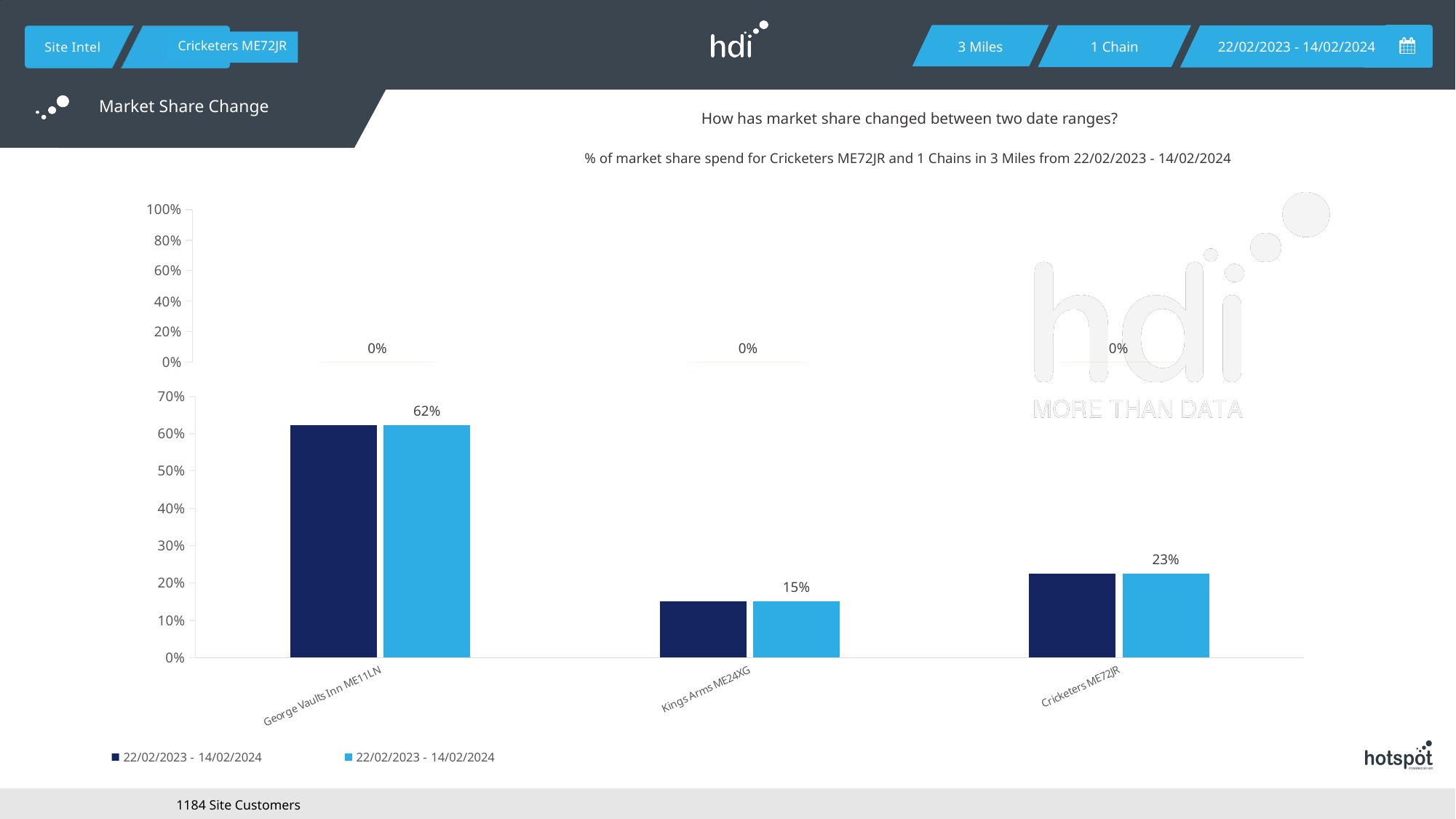
In the bottom chart, what value is labelled for Kings Arms ME24XG? 15% In the bottom chart, what is the difference between the labelled values for George Vaults Inn ME11LN and Cricketers ME72JR? 39% How many categories are shown on the x axis of the bottom chart? 3 In the bottom chart, what value is labelled for Cricketers ME72JR? 23% In the bottom chart, which has the larger market share, Cricketers ME72JR or Kings Arms ME24XG? Cricketers ME72JR What kind of chart is the bottom chart? bar chart In the top chart, what value is labelled for Kings Arms ME24XG? 0% In the bottom chart, is the value for George Vaults Inn ME11LN greater or less than 50%? greater In the bottom chart, what value is labelled for George Vaults Inn ME11LN? 62% In the bottom chart, which category has the lowest market share? Kings Arms ME24XG In the bottom chart, which category has the highest market share? George Vaults Inn ME11LN How many series does the legend of the bottom chart list? 2